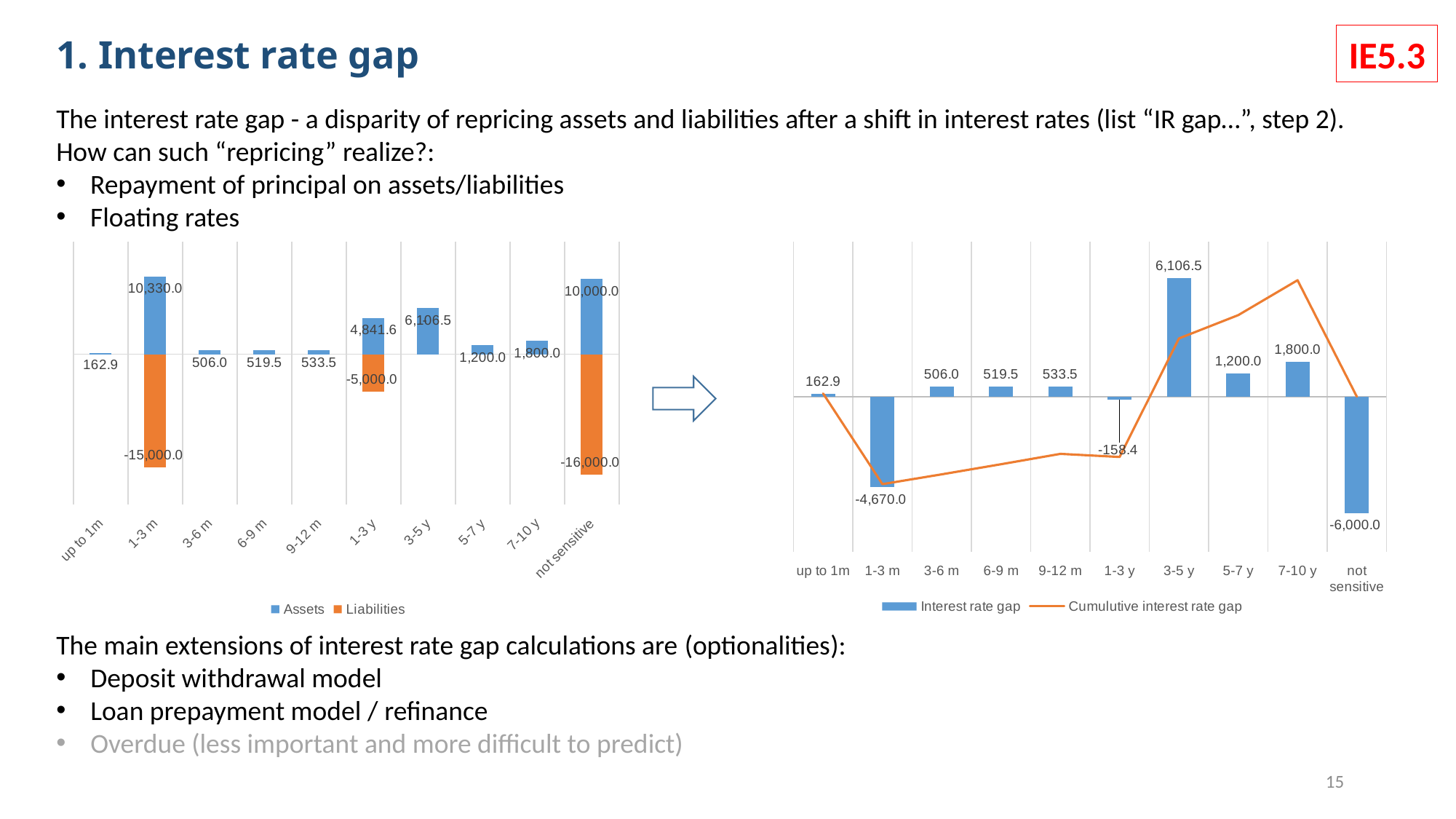
In the right chart, which category has the highest Interest rate gap value? 3-5 y In the left chart, what is the Liabilities value for the not sensitive category? -16,000.0 In the left chart, what is the Liabilities value for the 1-3 y category? -5,000.0 In the left chart, what is the difference between the Assets value and the Liabilities value for the 1-3 m category? 25,330.0 What are the two series named in the legend of the right chart? Interest rate gap and Cumulutive interest rate gap In the right chart, which is larger, the Interest rate gap for 7-10 y or for 5-7 y? 7-10 y In the right chart, what is the Interest rate gap value for the 1-3 m category? -4,670.0 In the right chart, which category has the lowest Interest rate gap value? not sensitive How many categories are shown on the x axis of the right chart? 10 In the left chart, what is the Assets value for the 1-3 m category? 10,330.0 In the right chart, what is the Interest rate gap value for the 1-3 y category? -158.4 How many series does the legend of the left chart list? 2